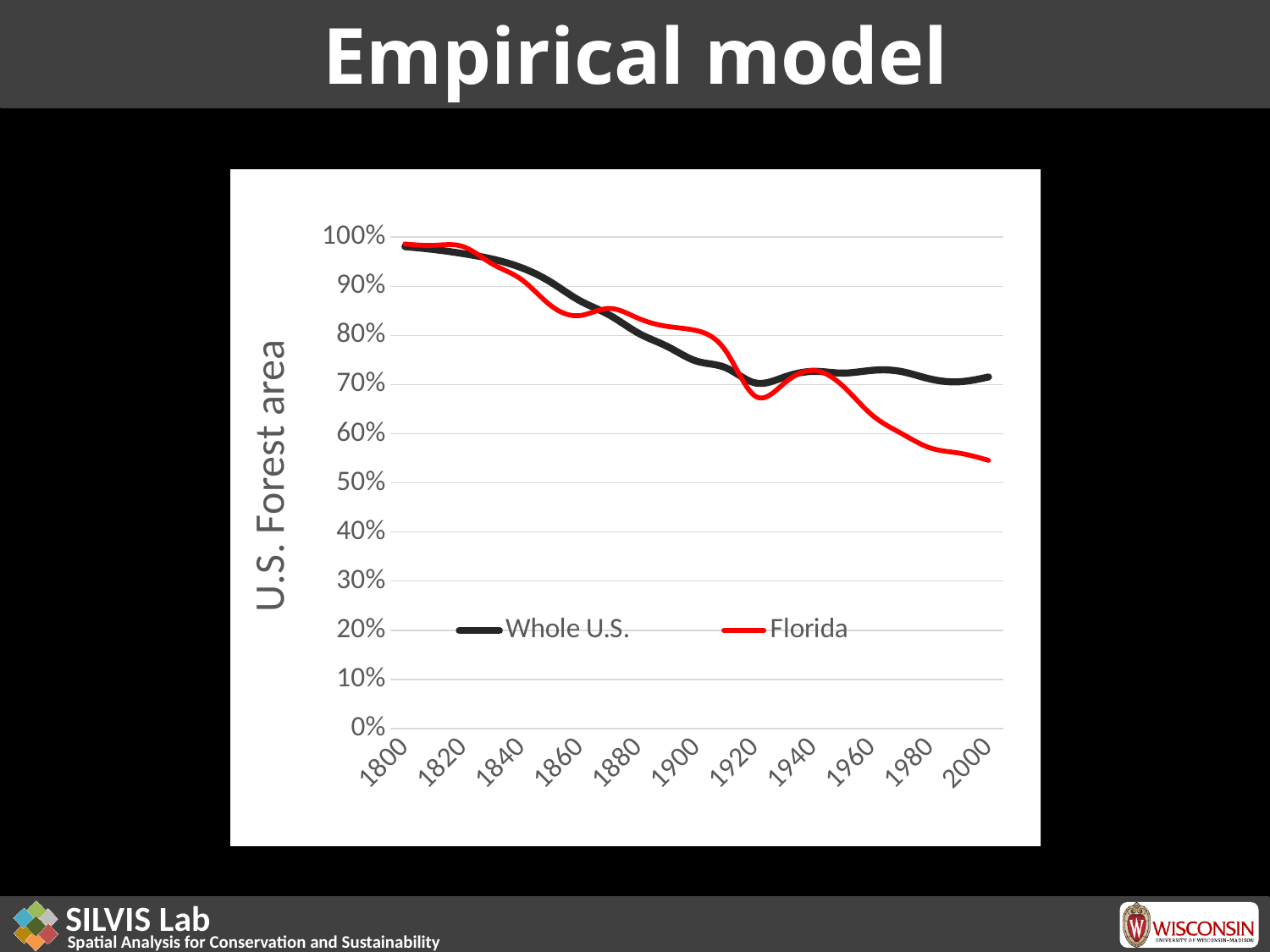
How many series does the chart's legend list? 2 What kind of chart is shown on the slide? Line chart How many year labels are shown along the x axis? 11 Is the value for Whole U.S. in 2000 greater or less than 60%? greater Is the value for Whole U.S. in 1800 greater or less than 90%? greater What is the label on the chart's vertical axis? U.S. Forest area In 1960, which series has the higher forest area, Whole U.S. or Florida? Whole U.S. Does the Florida line rise or fall overall from 1800 to 2000? Fall Is the value for Florida in 2000 greater or less than 60%? less Does the Whole U.S. line rise or fall overall from 1800 to 2000? Fall Which two series are listed in the chart's legend? Whole U.S. and Florida In 2000, which series has the higher forest area, Whole U.S. or Florida? Whole U.S.